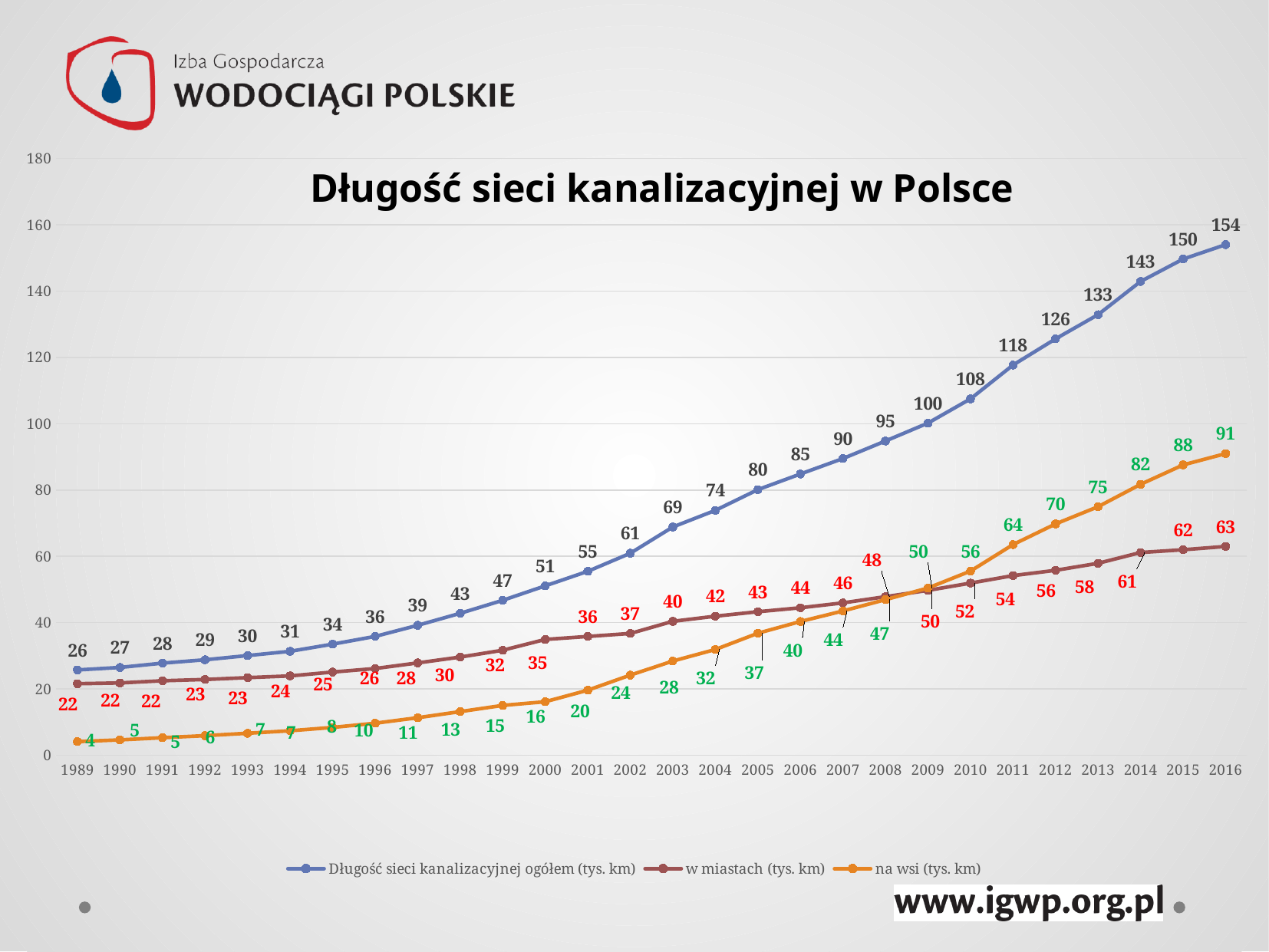
What type of chart is shown on the slide? line chart What is the difference between 'Długość sieci kanalizacyjnej ogółem (tys. km)' in 2016 and in 1989? 128 How many years are shown on the x axis? 28 Which is larger in 2016: 'w miastach (tys. km)' or 'na wsi (tys. km)'? na wsi (tys. km) How many series does the legend list? 3 What is the value of 'w miastach (tys. km)' in 2000? 35 What is the value of 'Długość sieci kanalizacyjnej ogółem (tys. km)' in 2016? 154 Does 'Długość sieci kanalizacyjnej ogółem (tys. km)' rise or fall from 1989 to 2016? rise What is the value of 'na wsi (tys. km)' in 2011? 64 In which year is 'na wsi (tys. km)' lowest? 1989 What is the title of the chart? Długość sieci kanalizacyjnej w Polsce What is the difference between 'na wsi (tys. km)' and 'w miastach (tys. km)' in 2016? 28